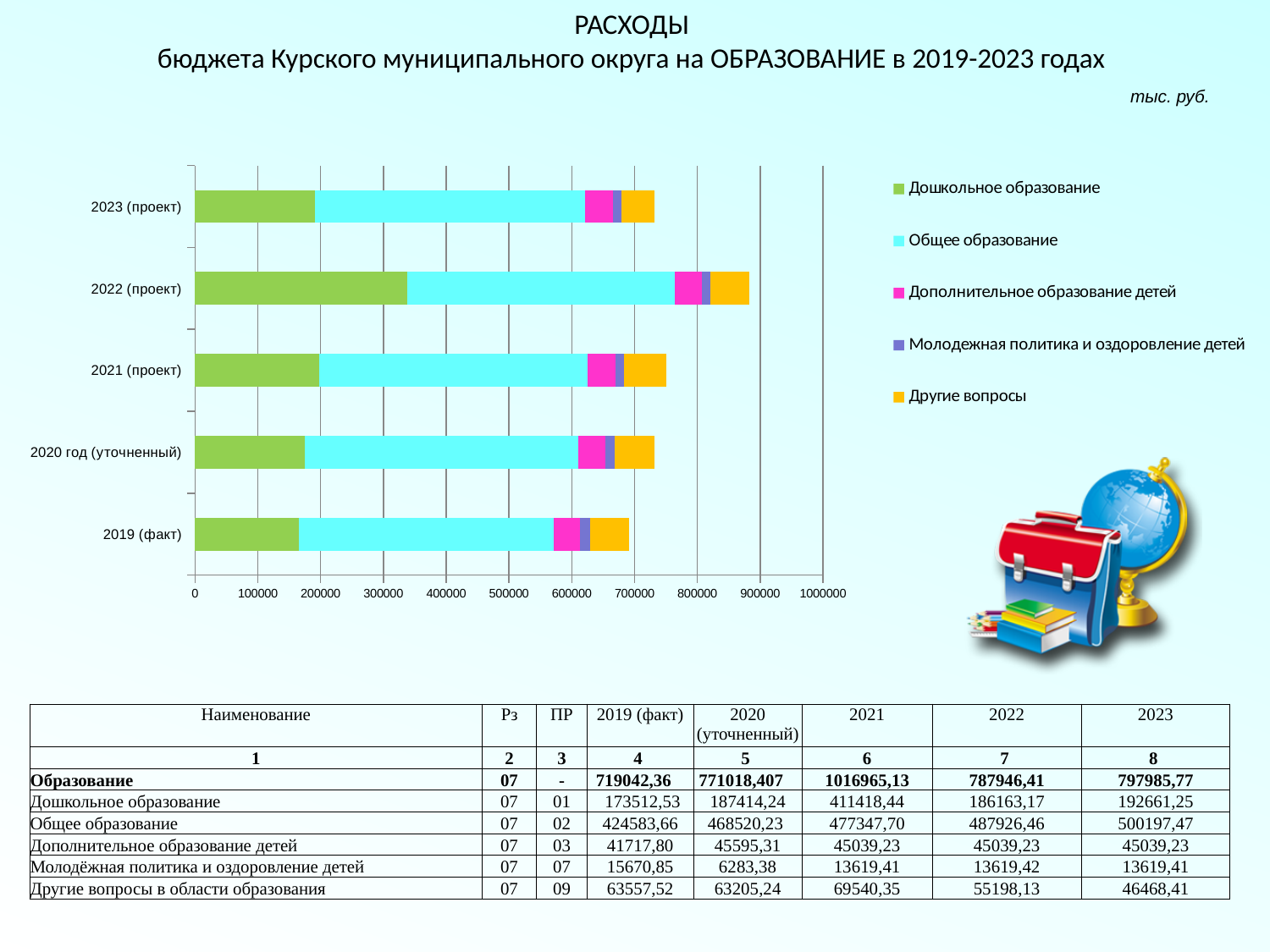
Which year has the longest total bar on the chart? 2022 (проект) Which legend entry is shown in yellow/orange? Другие вопросы Which is larger on the chart: the Дошкольное образование segment for 2022 (проект) or for 2023 (проект)? 2022 (проект) Which colour represents Общее образование in the chart legend? Light blue (cyan) Is the total bar for 2022 (проект) greater or less than 800000? greater How many series does the chart legend list? 5 What kind of chart is shown on the slide? Stacked bar chart Which year has the shortest total bar on the chart? 2019 (факт) Is the Дошкольное образование segment for 2022 (проект) greater or less than 300000? greater How many year categories are plotted on the chart? 5